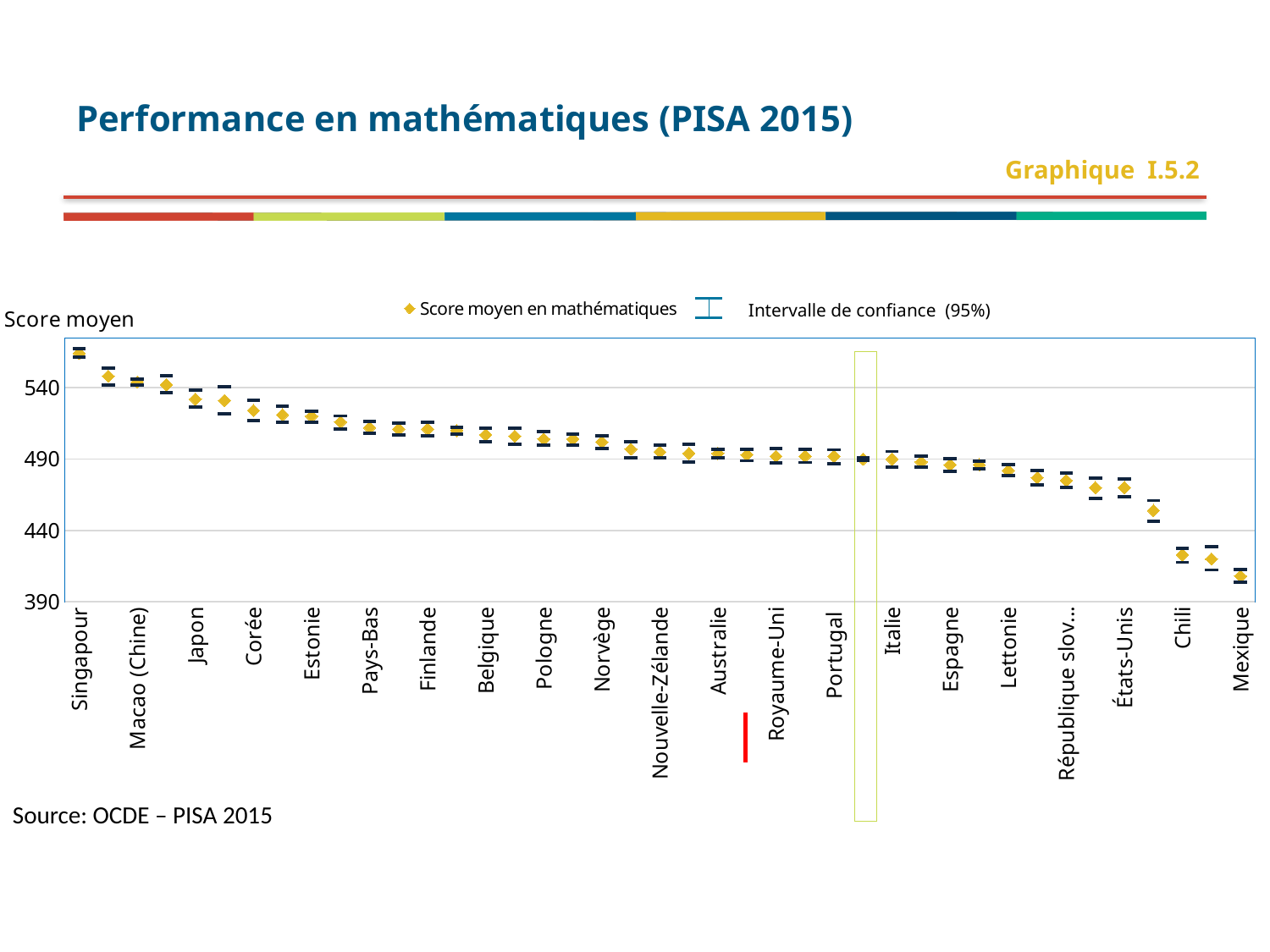
Do the mean mathematics scores rise or fall from left to right along the x axis? fall Which country has the lowest mean mathematics score on the chart? Mexique Is the mean mathematics score for Mexique greater or less than 440? less What is the title of the slide's chart? Performance en mathématiques (PISA 2015) Is the mean mathematics score for Chili greater or less than 440? less Which country has the highest mean mathematics score on the chart? Singapour Is the mean mathematics score for États-Unis greater or less than 490? less How many entries does the chart legend list? 2 Which has a higher mean mathematics score, États-Unis or Estonie? Estonie Which has a higher mean mathematics score, Japon or Chili? Japon